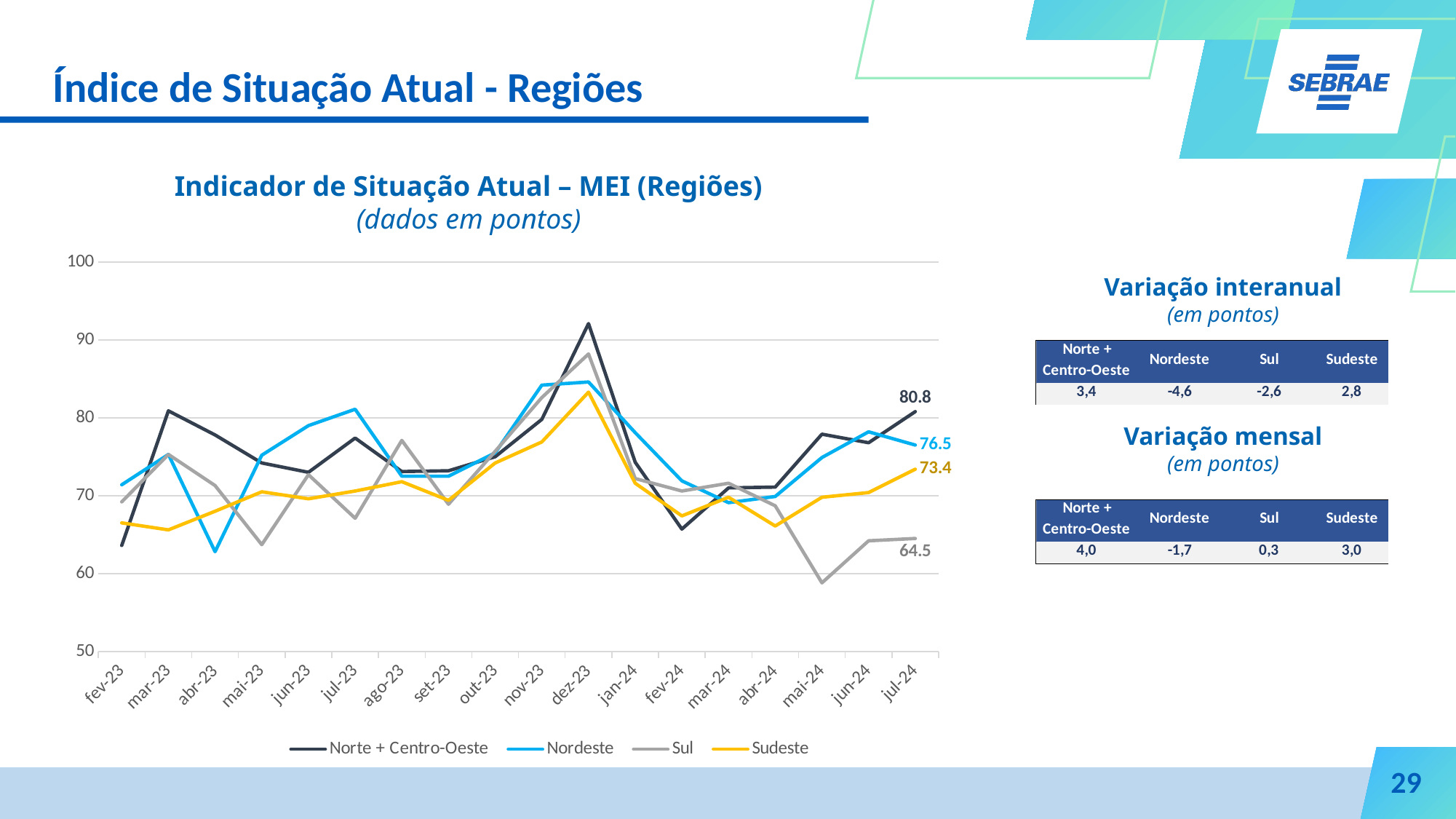
Is the value for Norte + Centro-Oeste in dez-23 greater or less than 90? greater What is the value for Nordeste in jul-24? 76.5 What is the value for Sudeste in jul-24? 73.4 Which series has the highest value in jul-24? Norte + Centro-Oeste How many series does the legend list? 4 What is the difference between the jul-24 values for Norte + Centro-Oeste and Sul? 16.3 What is the value for Sul in jul-24? 64.5 What kind of chart is shown on the slide? line chart What is the value for Norte + Centro-Oeste in jul-24? 80.8 How many months are plotted on the x axis? 18 In jul-24, which is larger: the value for Nordeste or the value for Sudeste? Nordeste Which series has the lowest value in jul-24? Sul